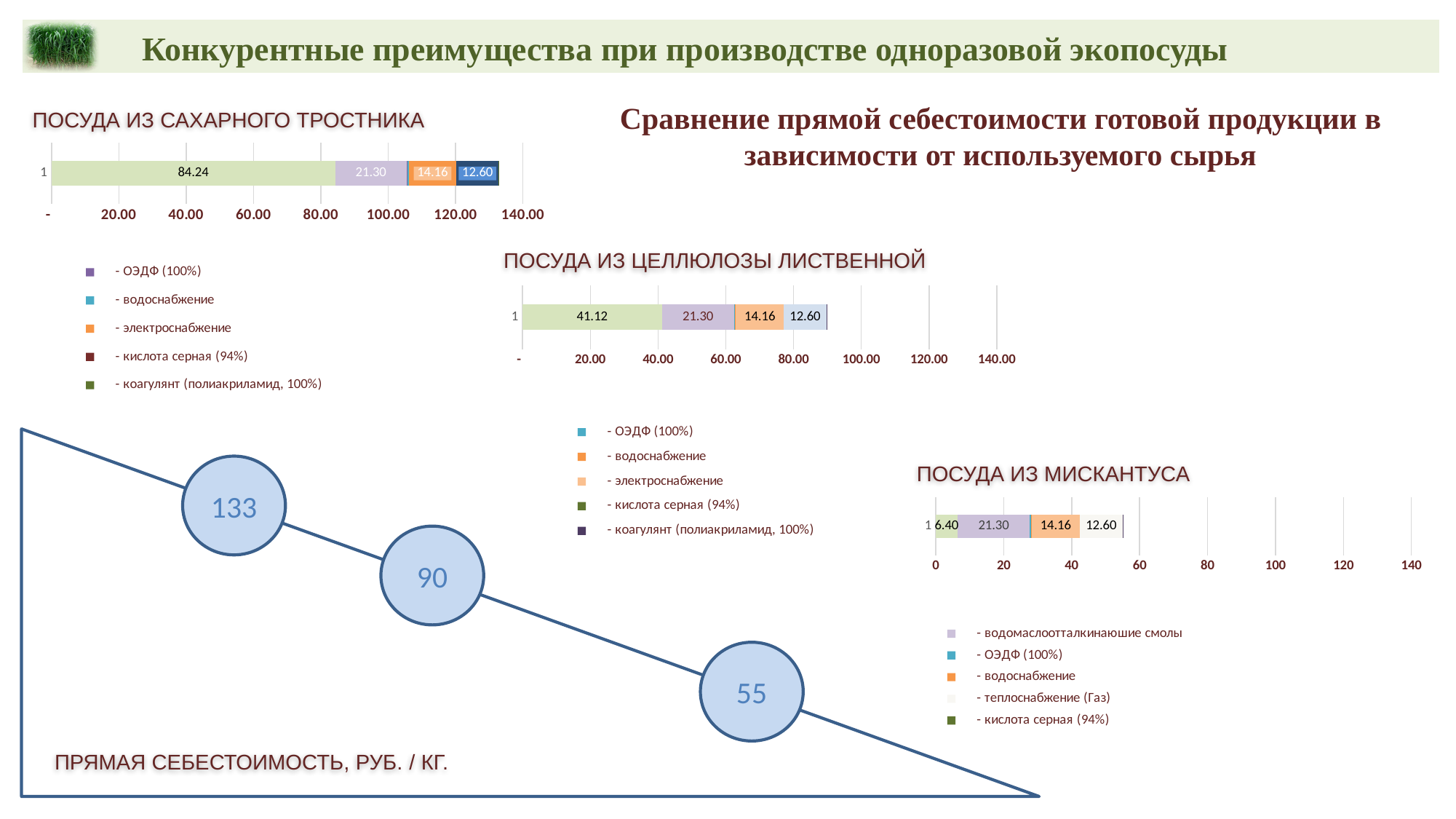
In the "ПОСУДА ИЗ ЦЕЛЛЮЛОЗЫ ЛИСТВЕННОЙ" chart, what is the value of the largest segment of the bar? 41.12 What is the difference between the largest segment in the "ПОСУДА ИЗ САХАРНОГО ТРОСТНИКА" chart (84.24) and the largest segment in the "ПОСУДА ИЗ ЦЕЛЛЮЛОЗЫ ЛИСТВЕННОЙ" chart (41.12)? 43.12 How many entries does the legend of the "ПОСУДА ИЗ МИСКАНТУСА" chart list? 5 Which chart has the longer stacked bar: "ПОСУДА ИЗ ЦЕЛЛЮЛОЗЫ ЛИСТВЕННОЙ" or "ПОСУДА ИЗ МИСКАНТУСА"? ПОСУДА ИЗ ЦЕЛЛЮЛОЗЫ ЛИСТВЕННОЙ In the "ПОСУДА ИЗ САХАРНОГО ТРОСТНИКА" chart, does the stacked bar end at a value greater or less than 120.00? greater In the "ПОСУДА ИЗ САХАРНОГО ТРОСТНИКА" chart, what is the value of the largest segment of the bar? 84.24 What kind of chart is "ПОСУДА ИЗ САХАРНОГО ТРОСТНИКА"? Stacked bar chart